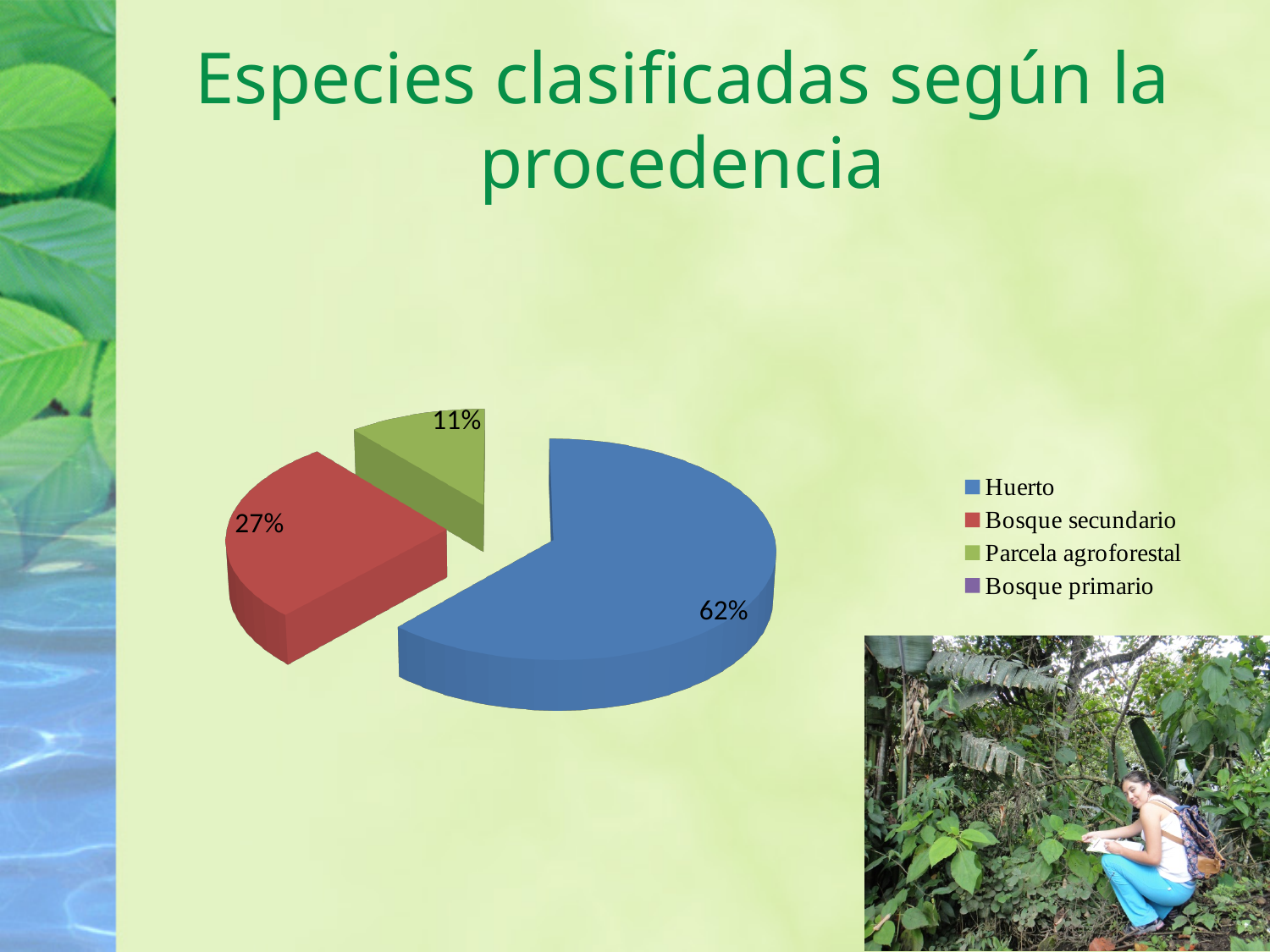
How many entries does the legend list? 4 What is the title of the slide containing the chart? Especies clasificadas según la procedencia What colour is the Huerto slice in the pie chart? blue What percentage of the pie does Parcela agroforestal account for? 11% What percentage of the pie does Huerto account for? 62% How many slices with percentage labels are visible in the pie? 3 What kind of chart is shown on the slide? pie chart Which category has the largest share of the pie? Huerto Which of the labelled slices has the smallest share of the pie? Parcela agroforestal What percentage of the pie does Bosque secundario account for? 27% What is the difference in percentage points between the Huerto and Bosque secundario shares? 35 Which is larger, the share for Bosque secundario or the share for Parcela agroforestal? Bosque secundario